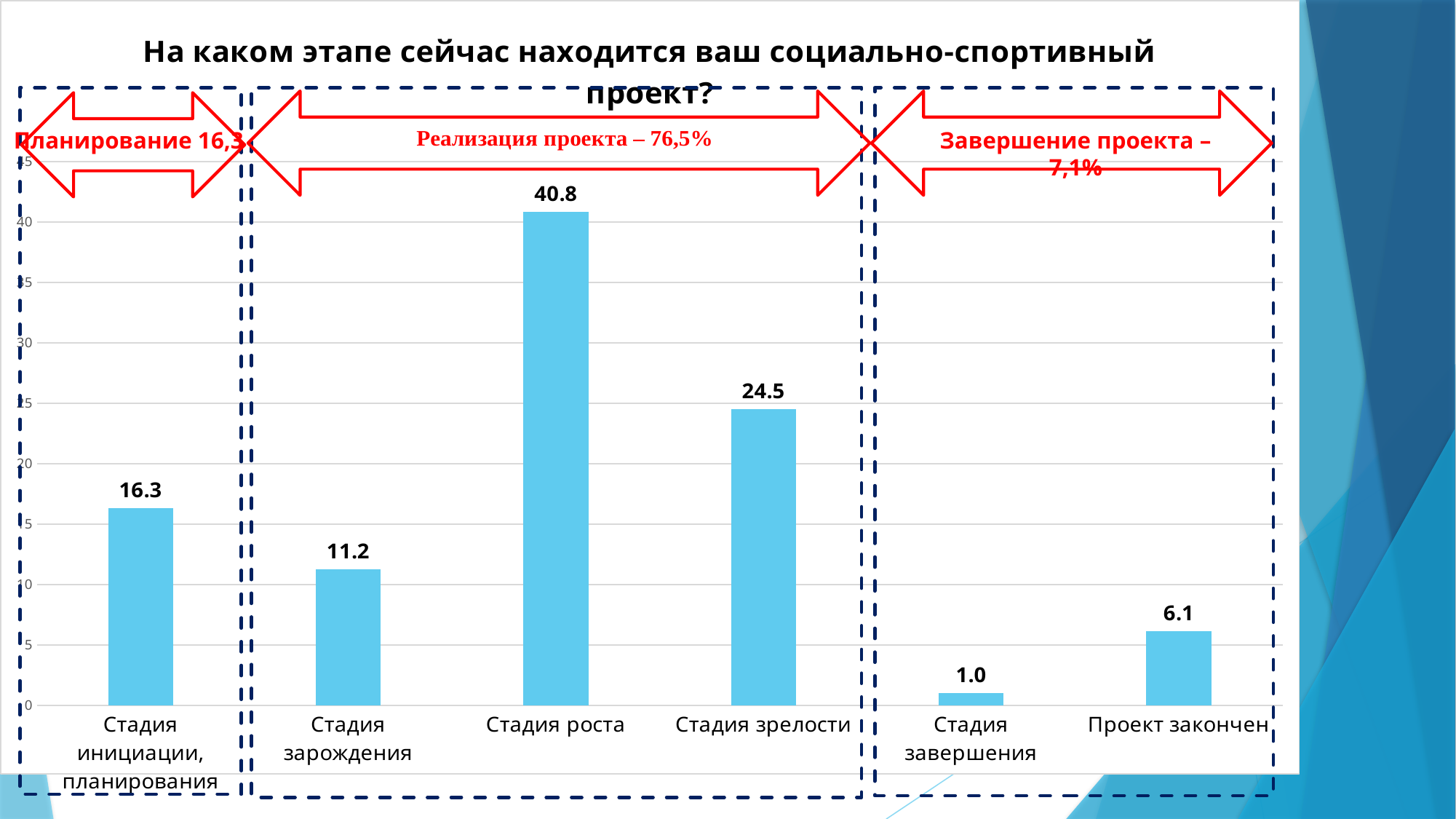
Which category has the lowest value? Стадия завершения How many categories are shown on the x axis of the chart? 6 Is the value for Стадия зрелости greater or less than 20? greater What kind of chart is shown on the slide? bar chart What is the value for Проект закончен? 6.1 What is the title of the chart? На каком этапе сейчас находится ваш социально-спортивный проект? What is the value for Стадия инициации, планирования? 16.3 What is the difference between the values for Стадия роста and Стадия зрелости? 16.3 Which category has the highest value? Стадия роста What is the value for Стадия зрелости? 24.5 Which is larger, the value for Стадия зарождения or the value for Стадия инициации, планирования? Стадия инициации, планирования What is the value for Стадия роста? 40.8